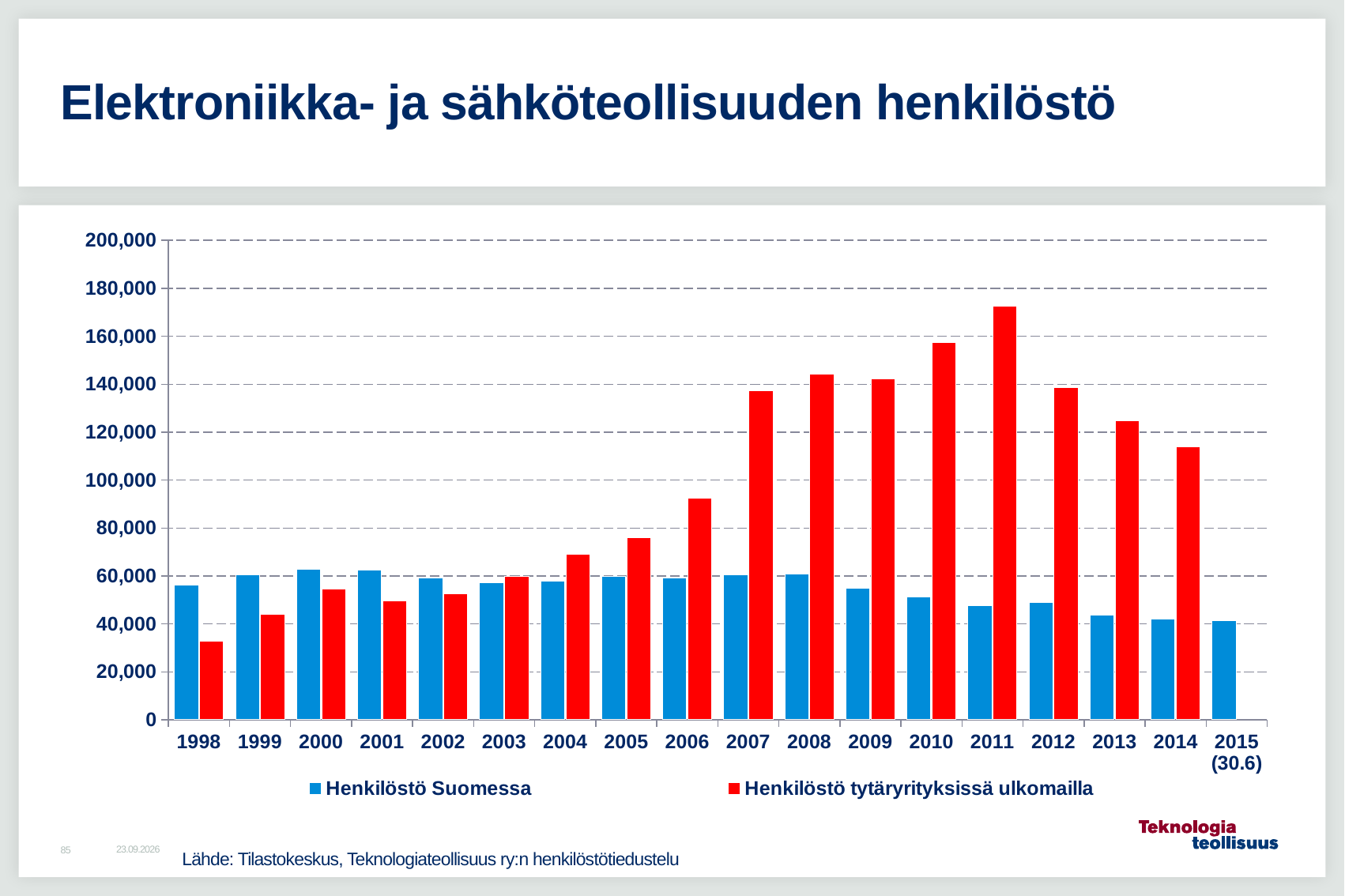
What kind of chart is shown on the slide? Bar chart In 2007, which is larger: Henkilöstö Suomessa or Henkilöstö tytäryrityksissä ulkomailla? Henkilöstö tytäryrityksissä ulkomailla Is the value for Henkilöstö tytäryrityksissä ulkomailla in 1998 greater or less than 40,000? less Is the value for Henkilöstö tytäryrityksissä ulkomailla in 2011 greater or less than 160,000? greater Is the value for Henkilöstö Suomessa in 2012 greater or less than 60,000? less How many series does the legend list? 2 In which year is the value for Henkilöstö tytäryrityksissä ulkomailla highest? 2011 In which year is the value for Henkilöstö tytäryrityksissä ulkomailla lowest? 1998 Does the value for Henkilöstö tytäryrityksissä ulkomailla rise or fall from 2011 to 2014? Fall How many years (categories) are shown on the x axis? 18 In 1998, which is larger: Henkilöstö Suomessa or Henkilöstö tytäryrityksissä ulkomailla? Henkilöstö Suomessa